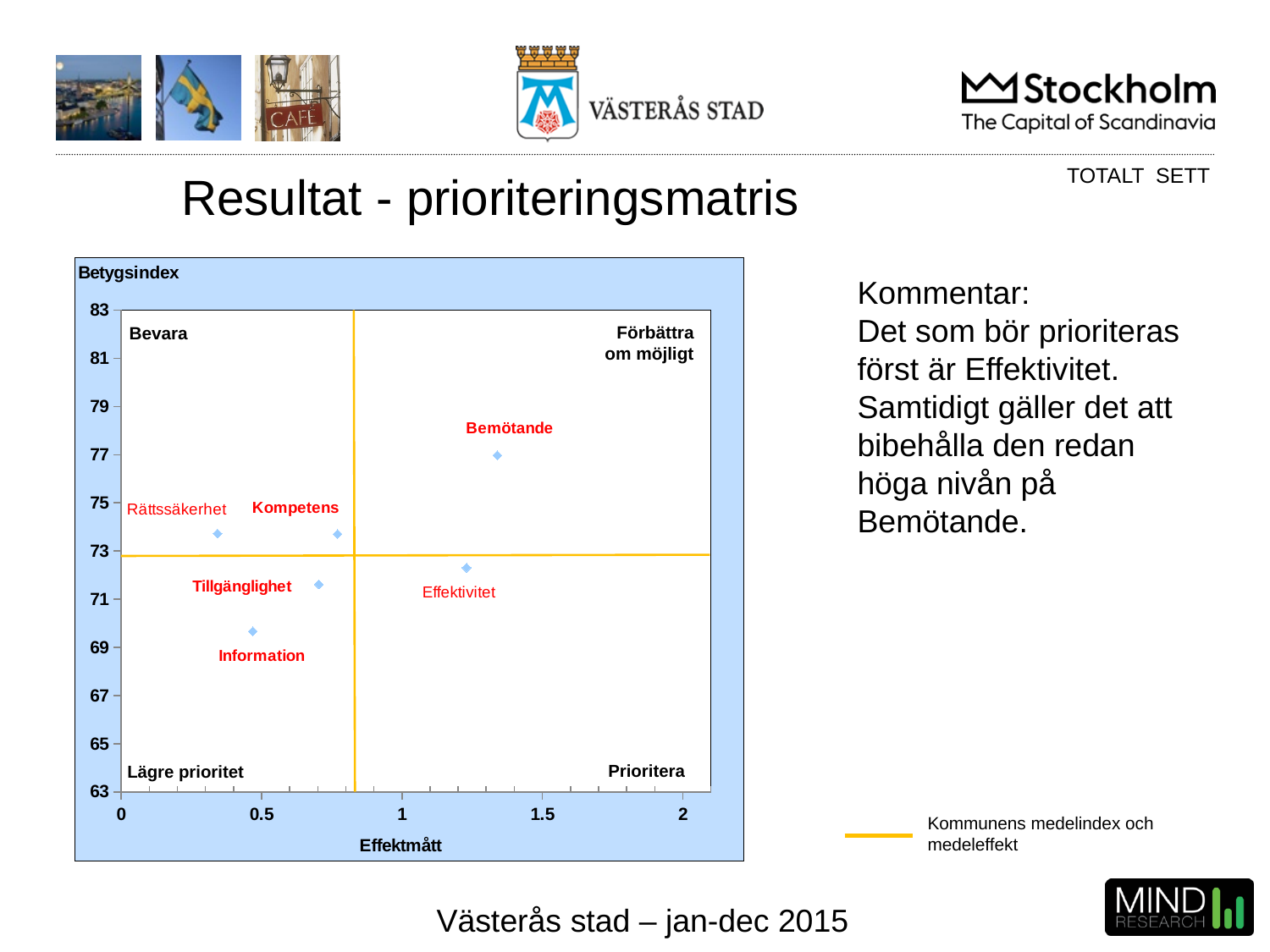
Which point has the highest Betygsindex? Bemötande Is the Effektmått for Effektivitet greater or less than 1? greater How many data points are plotted in the chart? 6 Is the Betygsindex for Bemötande greater or less than 75? greater Which has the higher Betygsindex, Tillgänglighet or Information? Tillgänglighet What is the label of the horizontal axis of the chart? Effektmått Which point has the lowest Effektmått? Rättssäkerhet Which point has the highest Effektmått? Bemötande Is the Effektmått for Kompetens greater or less than 1? less Which point has the lowest Betygsindex? Information What kind of chart is shown on the slide? scatter chart